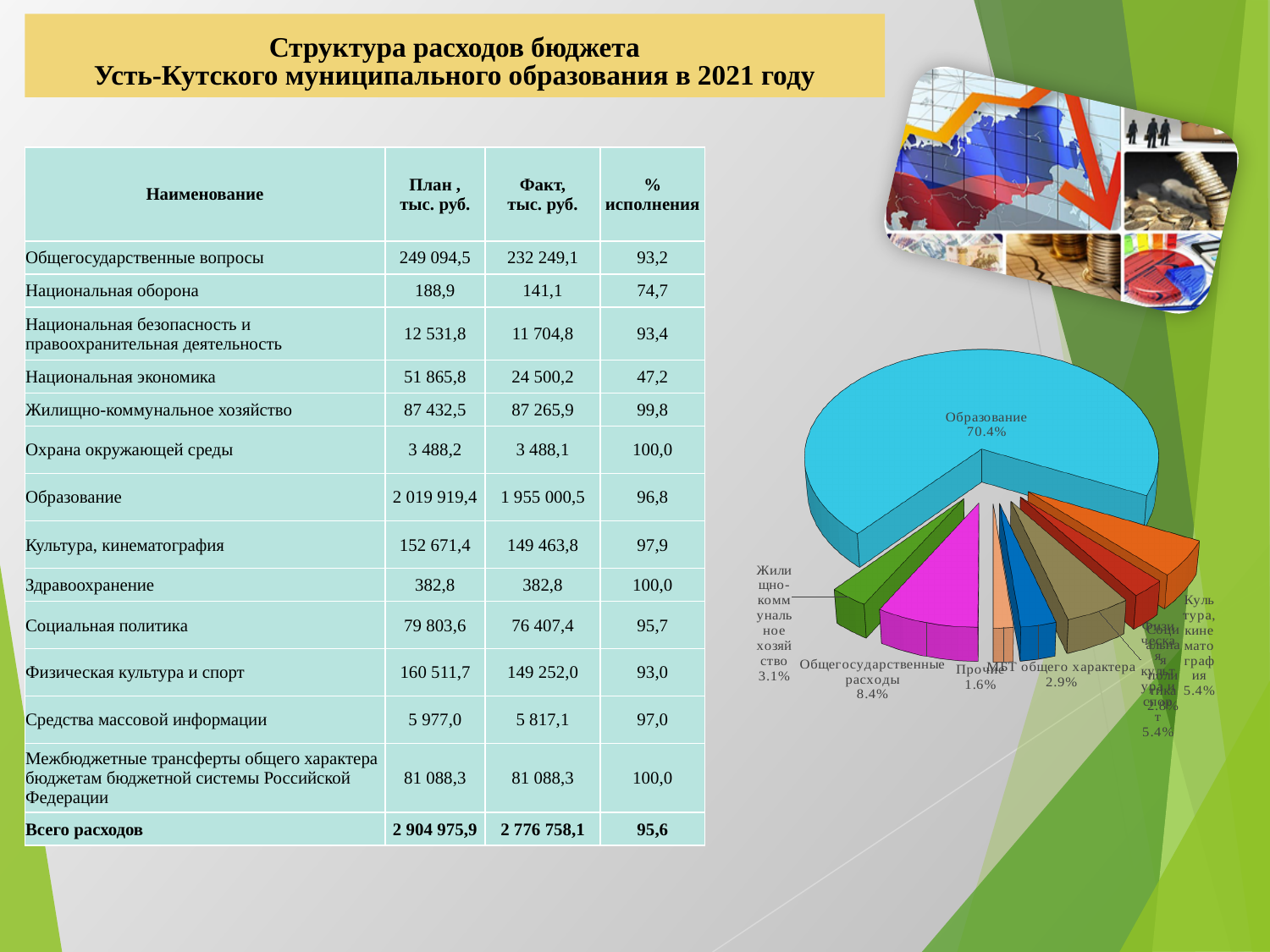
In the pie chart, what share is shown for Жилищно-коммунальное хозяйство? 3.1% In the pie chart, what share is shown for Прочие? 1.6% What kind of chart is shown on the right side of the slide? pie chart In the pie chart, is the share for Образование greater or less than 50%? greater In the pie chart, what share is shown for Общегосударственные расходы? 8.4% In the pie chart, what share is shown for Образование? 70.4% What colour is the Образование slice in the pie chart? light blue In the pie chart, what is the difference in percentage points between Общегосударственные расходы (8.4%) and Жилищно-коммунальное хозяйство (3.1%)? 5.3 In the pie chart, which labelled category has the smallest share? Прочие In the pie chart, which is larger: the share for Общегосударственные расходы or for Жилищно-коммунальное хозяйство? Общегосударственные расходы In the pie chart, what share is shown for МБТ общего характера? 2.9% In the pie chart, which category has the largest share? Образование